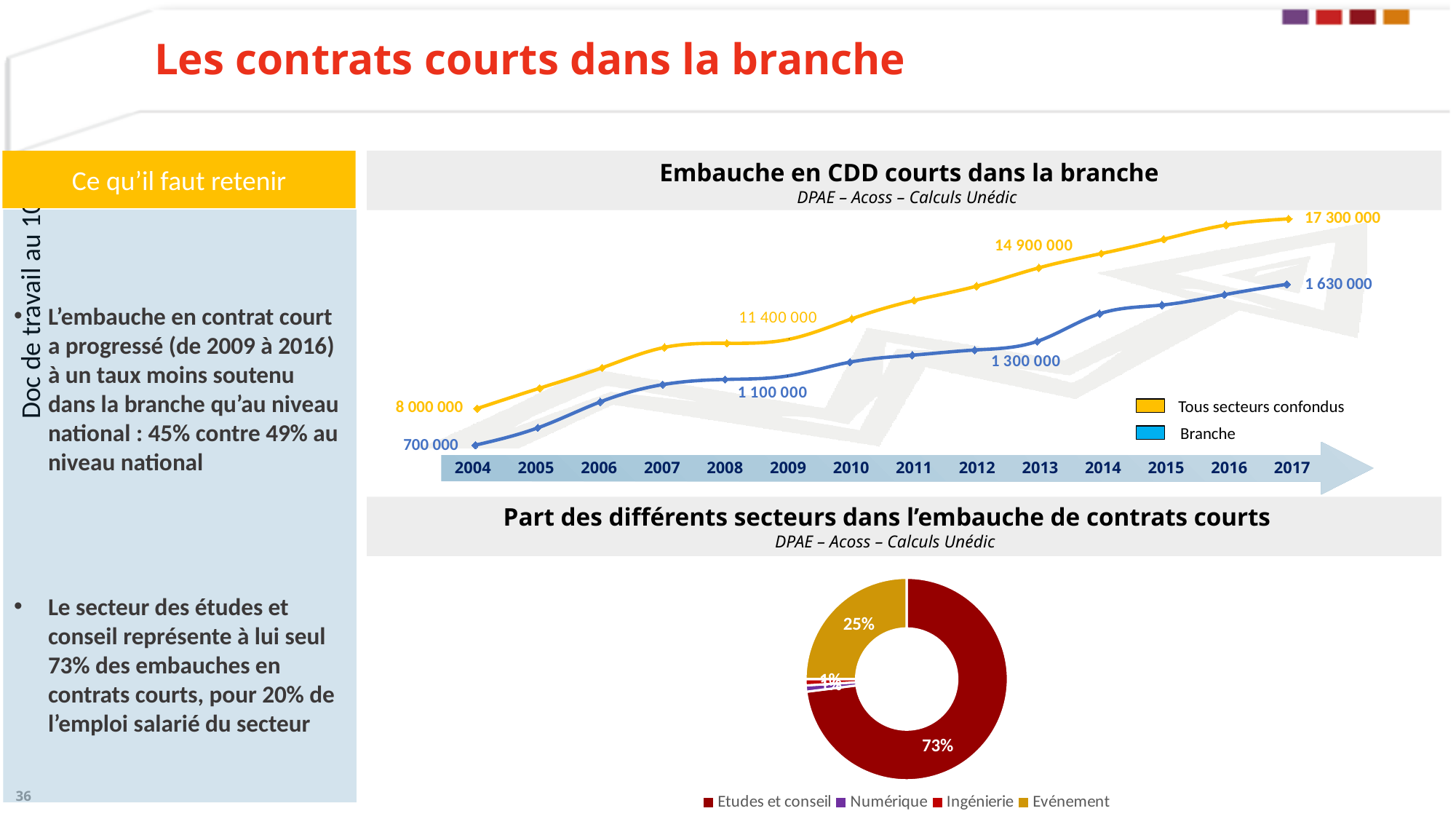
In the chart 'Embauche en CDD courts dans la branche', how many series does the legend list? 2 In the chart 'Embauche en CDD courts dans la branche', how many years are shown on the x axis? 14 What kind of chart is 'Embauche en CDD courts dans la branche'? line chart In the chart 'Embauche en CDD courts dans la branche', do the values for 'Branche' rise or fall from 2004 to 2017? rise In the chart 'Embauche en CDD courts dans la branche', what is the value for 'Tous secteurs confondus' in 2017? 17 300 000 In the chart 'Embauche en CDD courts dans la branche', what is the value for 'Branche' in 2004? 700 000 In the chart 'Embauche en CDD courts dans la branche', what is the value for 'Branche' in 2017? 1 630 000 In the chart 'Embauche en CDD courts dans la branche', by how much did 'Branche' increase between 2004 and 2017? 930 000 In the chart 'Part des différents secteurs dans l'embauche de contrats courts', how many sectors does the legend list? 4 In the chart 'Part des différents secteurs dans l'embauche de contrats courts', what share does 'Etudes et conseil' represent? 73% In the chart 'Embauche en CDD courts dans la branche', what is the value for 'Tous secteurs confondus' in 2004? 8 000 000 In the chart 'Embauche en CDD courts dans la branche', by how much did 'Tous secteurs confondus' increase between 2004 and 2017? 9 300 000